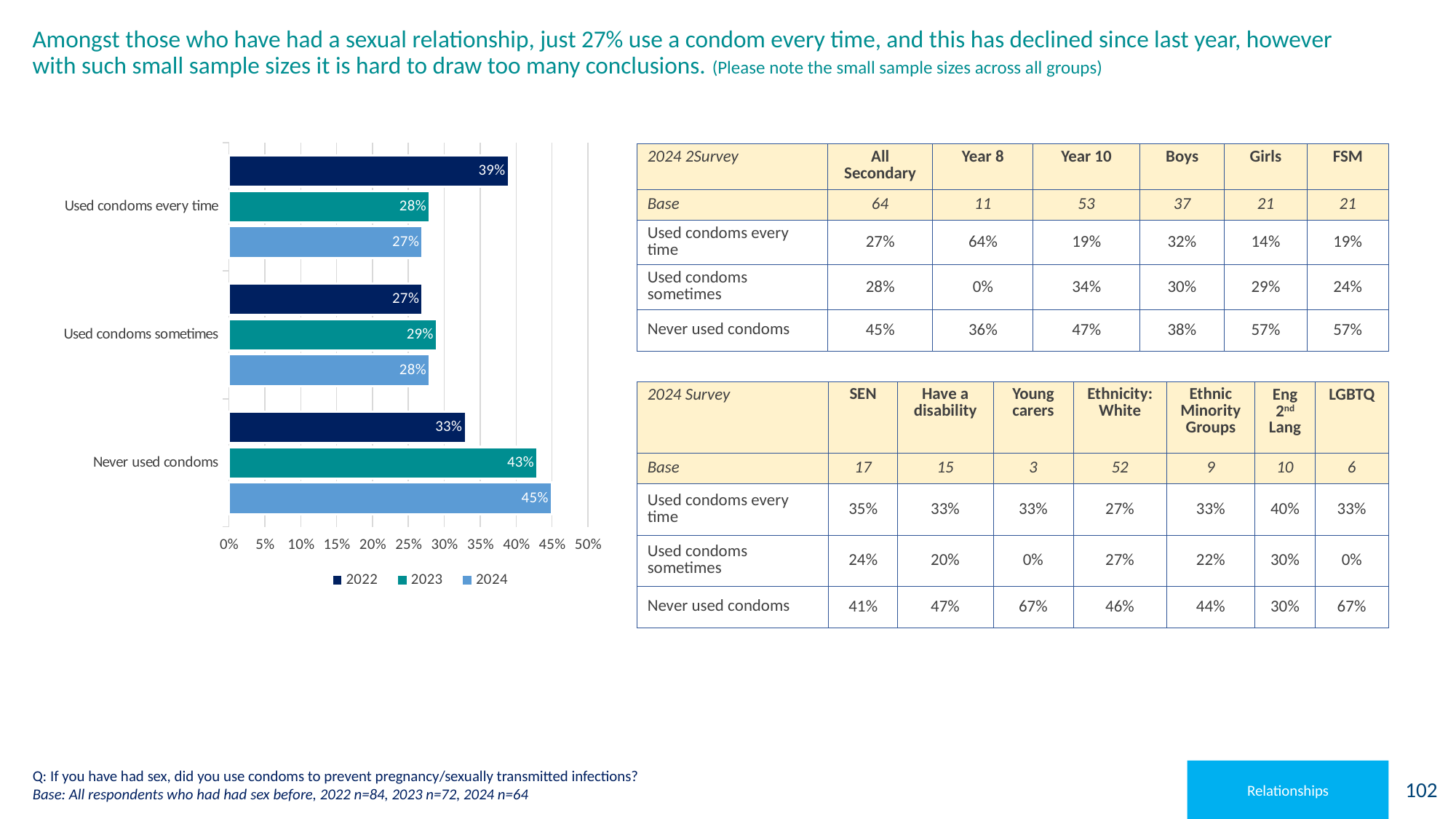
Does the value for 'Never used condoms' rise or fall from 2022 to 2024? rise How many categories are shown on the chart? 3 What kind of chart is shown on the slide? bar chart In 2023, which is larger: 'Never used condoms' or 'Used condoms every time'? Never used condoms What is the 2024 value for 'Used condoms every time'? 27% What is the difference between the 2024 and 2022 values for 'Never used condoms'? 12 percentage points Which category has the highest 2024 value? Never used condoms How many series does the chart legend list? 3 Which category has the lowest 2022 value? Used condoms sometimes What is the 2023 value for 'Used condoms sometimes'? 29% What is the 2022 value for 'Never used condoms'? 33% Is the 2022 value for 'Used condoms every time' greater or less than 35%? greater